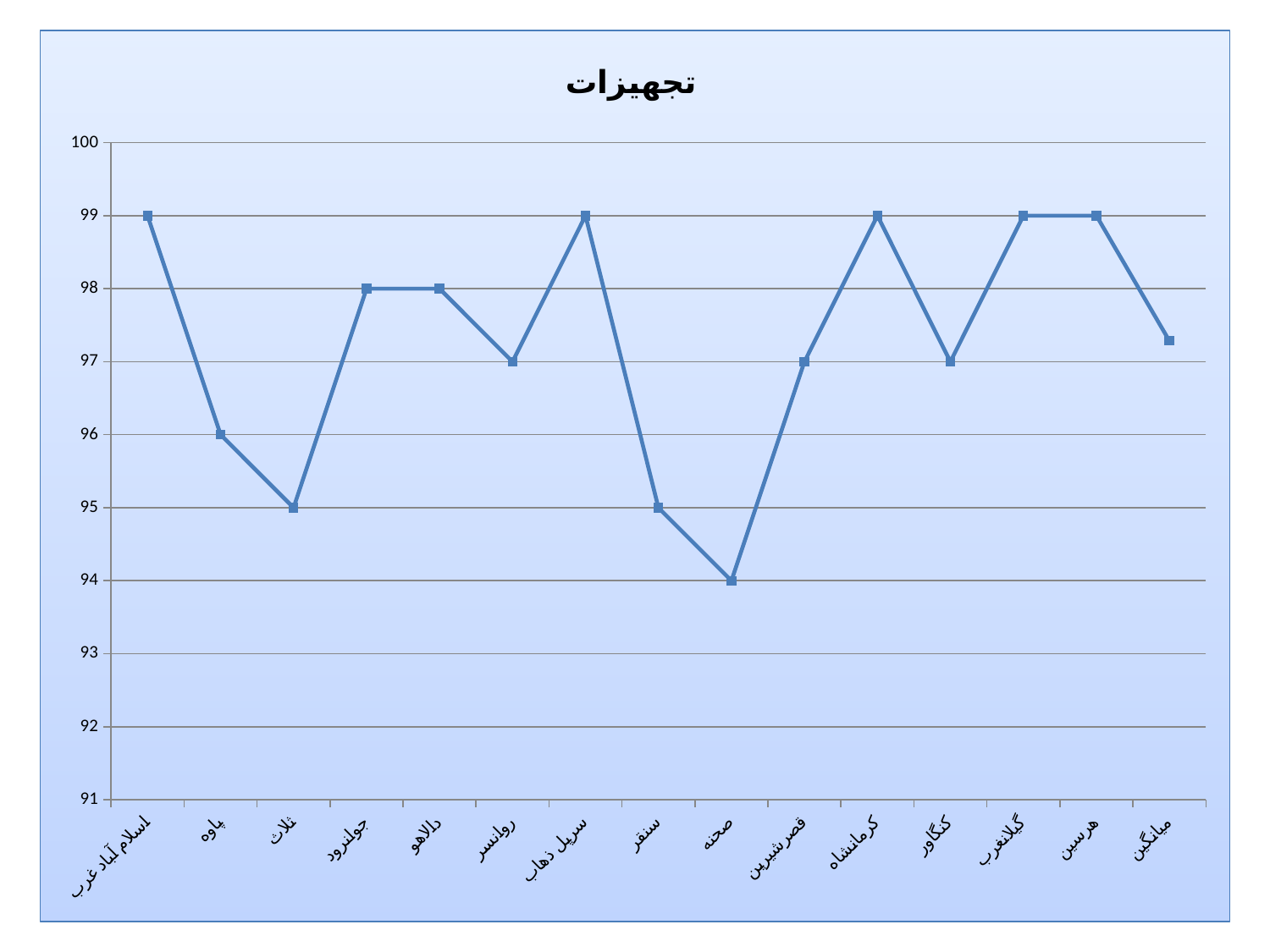
What is the difference between the values for اسلام آباد غرب and ثلاث? 4 What is the value for جوانرود? 98 Is the value for میانگین greater or less than 97? greater How many categories are plotted along the x axis? 15 What is the title of the chart? تجهیزات Which category has the lowest value? صحنه What kind of chart is shown on the slide? line chart What is the value for کرمانشاه? 99 Do the values rise or fall from اسلام آباد غرب to ثلاث? fall What is the value for صحنه? 94 What is the value for پاوه? 96 Which is larger, the value for سنقر or the value for قصرشیرین? قصرشیرین